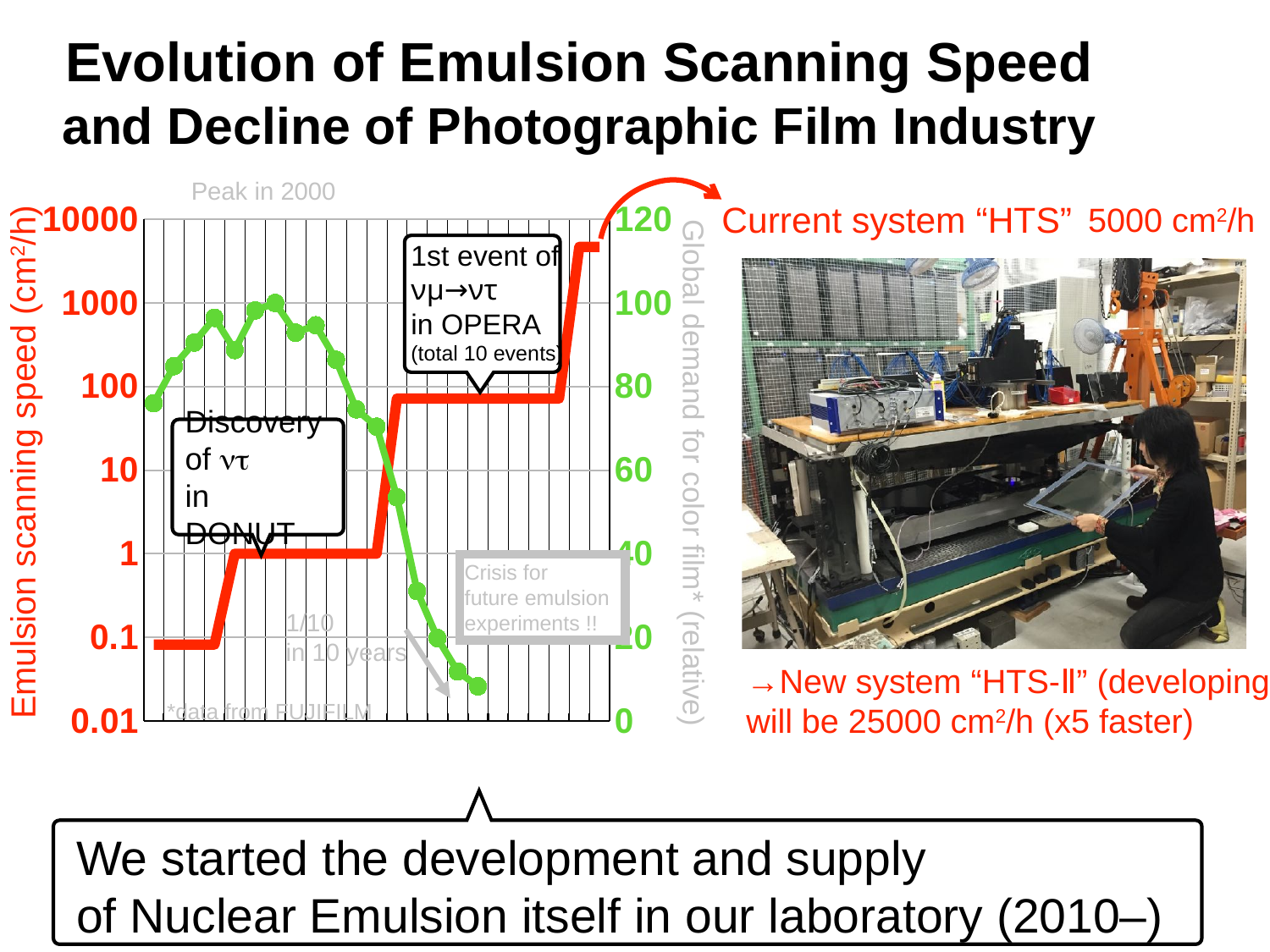
Does the red emulsion scanning speed line rise or fall overall from left to right? rise What kind of chart is shown on the slide? line chart Is the final value of the green color film demand line greater or less than 20 on the right axis? less What is the title of the left vertical axis of the chart? Emulsion scanning speed (cm²/h) What is the lowest tick value shown on the left (red) axis of the chart? 0.01 Does the green color film demand line rise or fall over the right-hand portion of the chart after its peak? fall What is the title of the right vertical axis of the chart? Global demand for color film* (relative) According to the annotation on the chart, in which year did global demand for color film peak? 2000 Is the value of the red scanning speed line at its final plateau greater or less than 1000 on the left axis? greater Is the value of the red scanning speed line at its third plateau (around the OPERA annotation) greater or less than 100 on the left axis? less What is the highest tick value shown on the right (green) axis of the chart? 120 What is the highest tick value shown on the left (red) axis of the chart? 10000